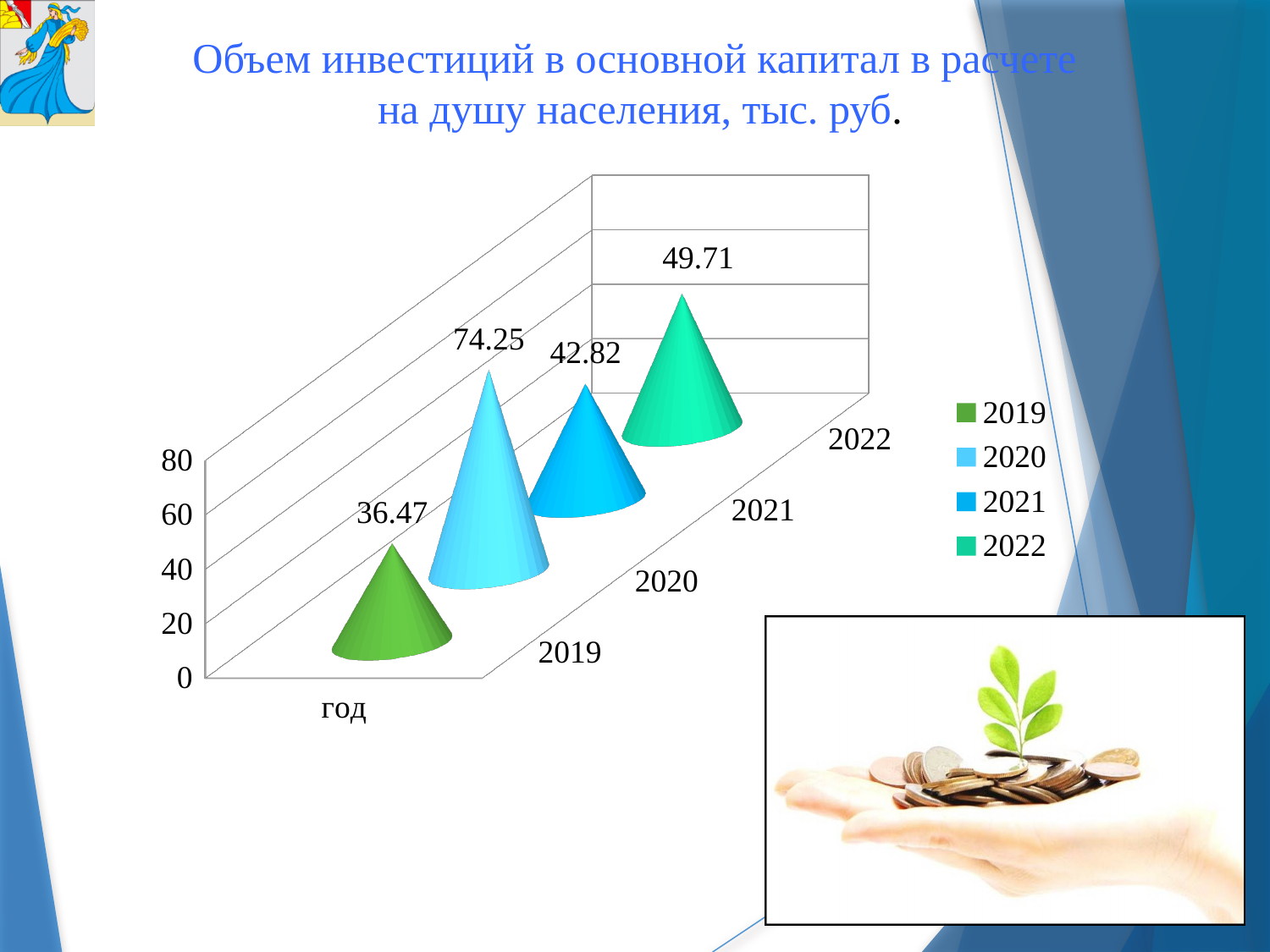
What is the value for 2021? 42.82 What is the difference between the values for 2020 and 2019? 37.78 What is the value for 2020? 74.25 Which year has the highest value? 2020 What is the value for 2019? 36.47 Which year has the lowest value? 2019 How many entries does the legend list? 4 How many years are shown on the chart? 4 Which is larger, the value for 2021 or the value for 2022? 2022 What is the label on the horizontal axis of the chart? год What is the value for 2022? 49.71 What is the difference between the values for 2022 and 2021? 6.89